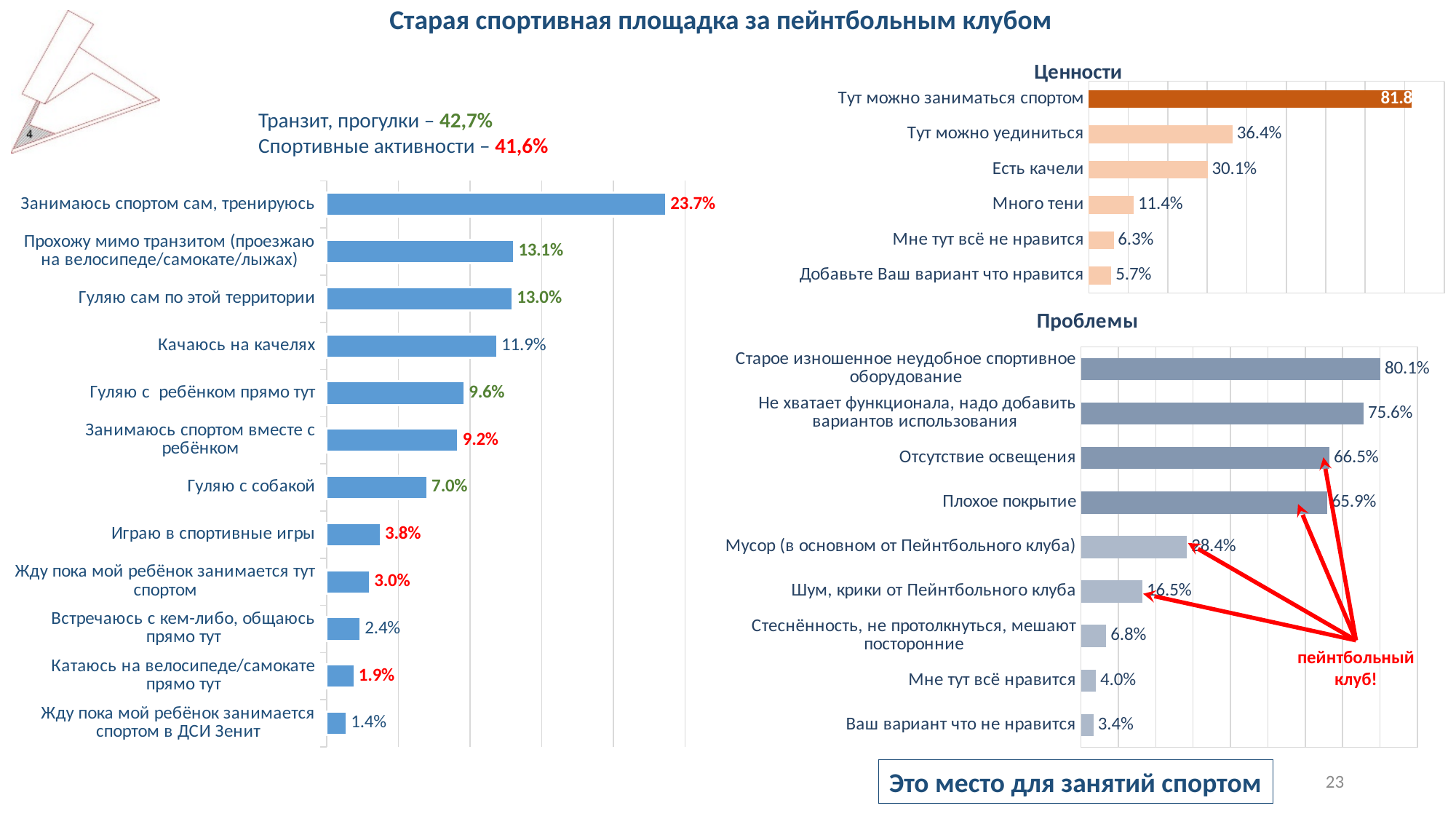
On the «Проблемы» chart, what is the value for «Отсутствие освещения»? 66.5% On the «Ценности» chart, what is the value for «Есть качели»? 30.1% On the «Ценности» chart, which category has the lowest value? Добавьте Ваш вариант что нравится How many categories are shown on the «Ценности» chart? 6 How many categories are shown on the left chart? 12 On the left chart, what is the value for «Качаюсь на качелях»? 11.9% On the «Проблемы» chart, what is the difference between «Старое изношенное неудобное спортивное оборудование» and «Не хватает функционала, надо добавить вариантов использования»? 4.5% What type of chart is the «Проблемы» chart? Bar chart On the left chart, which category has the highest value? Занимаюсь спортом сам, тренируюсь On the «Проблемы» chart, which is larger: «Мусор (в основном от Пейнтбольного клуба)» or «Шум, крики от Пейнтбольного клуба»? Мусор (в основном от Пейнтбольного клуба) On the left chart, what is the difference between «Гуляю с собакой» and «Играю в спортивные игры»? 3.2% On the «Проблемы» chart, which category has the highest value? Старое изношенное неудобное спортивное оборудование